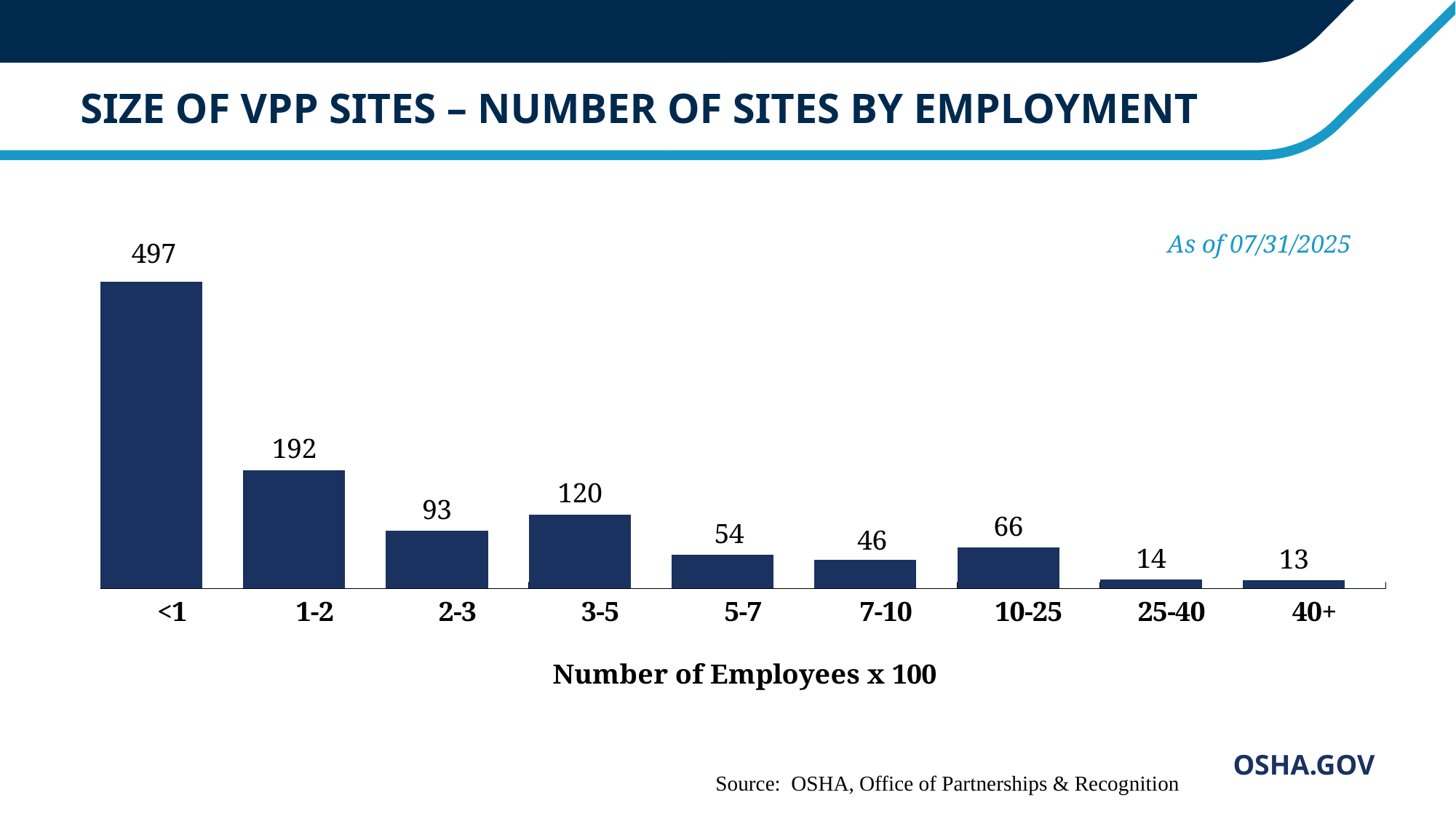
What is the number of sites in the "3-5" employment category? 120 Which category has more sites, "10-25" or "2-3"? 2-3 What is the x-axis title of the chart? Number of Employees x 100 What is the difference between the number of sites in the "<1" category and the "1-2" category? 305 How many employment categories are shown on the x axis? 9 Which employment category has the lowest number of sites? 40+ What is the difference between the number of sites in the "3-5" category and the "2-3" category? 27 What type of chart is shown on the slide? Bar chart What is the number of sites in the "10-25" employment category? 66 How many VPP sites have fewer than 100 employees (the "<1" category)? 497 Which employment category has the highest number of sites? <1 Which category has more sites, "5-7" or "7-10"? 5-7